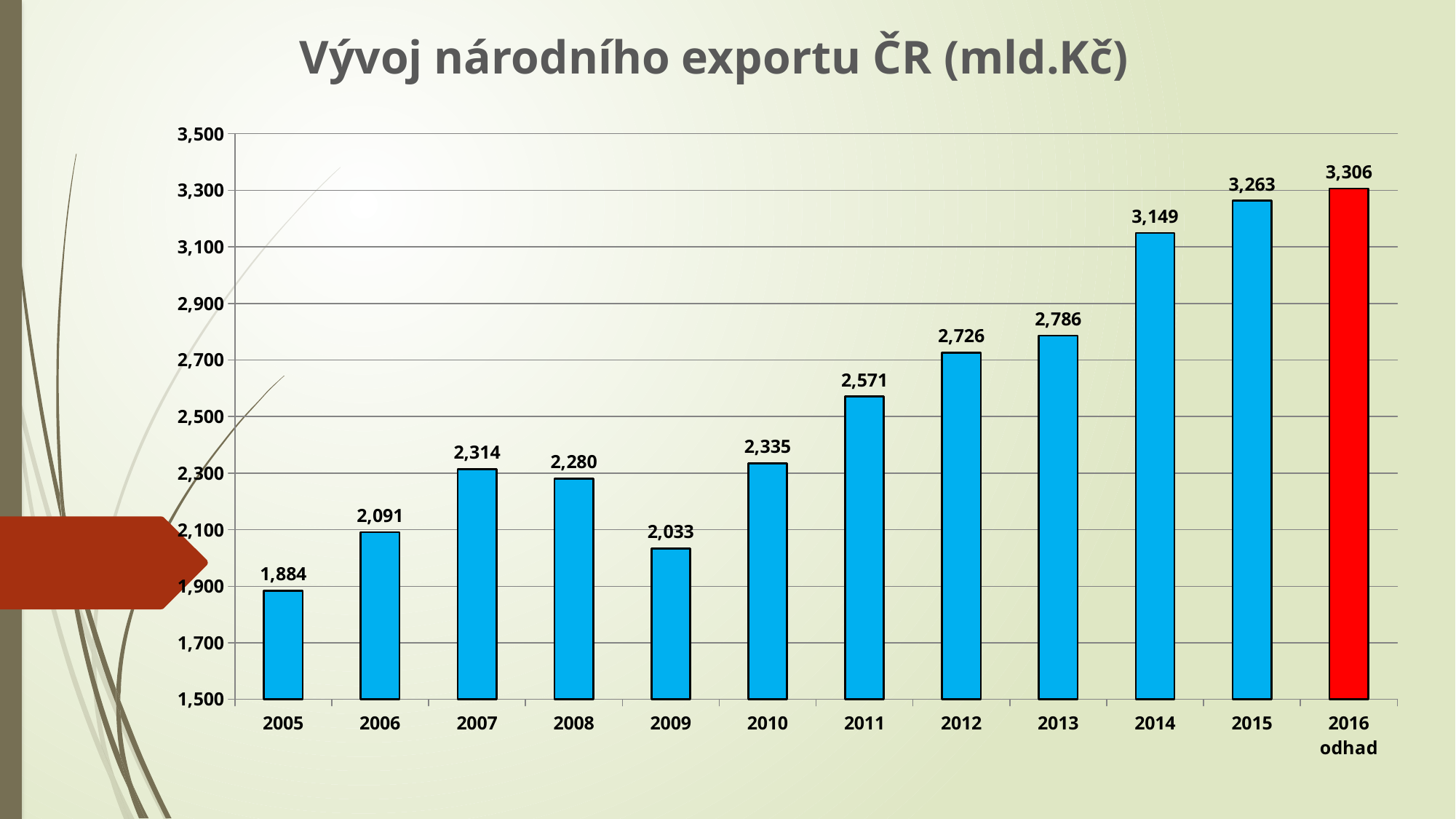
What is the value for 2014? 3,149 Which year has the lowest value? 2005 Which is larger, the value for 2007 or the value for 2008? 2007 What is the value for 2016 odhad? 3,306 Is the value for 2012 greater or less than 2,700? greater Which category has the highest value? 2016 odhad How many bars are shown in the chart? 12 Which bar is coloured red instead of blue? 2016 odhad What is the value for 2009? 2,033 What is the difference between the values for 2015 and 2014? 114 What kind of chart is shown on the slide? bar chart What is the difference between the values for 2008 and 2009? 247